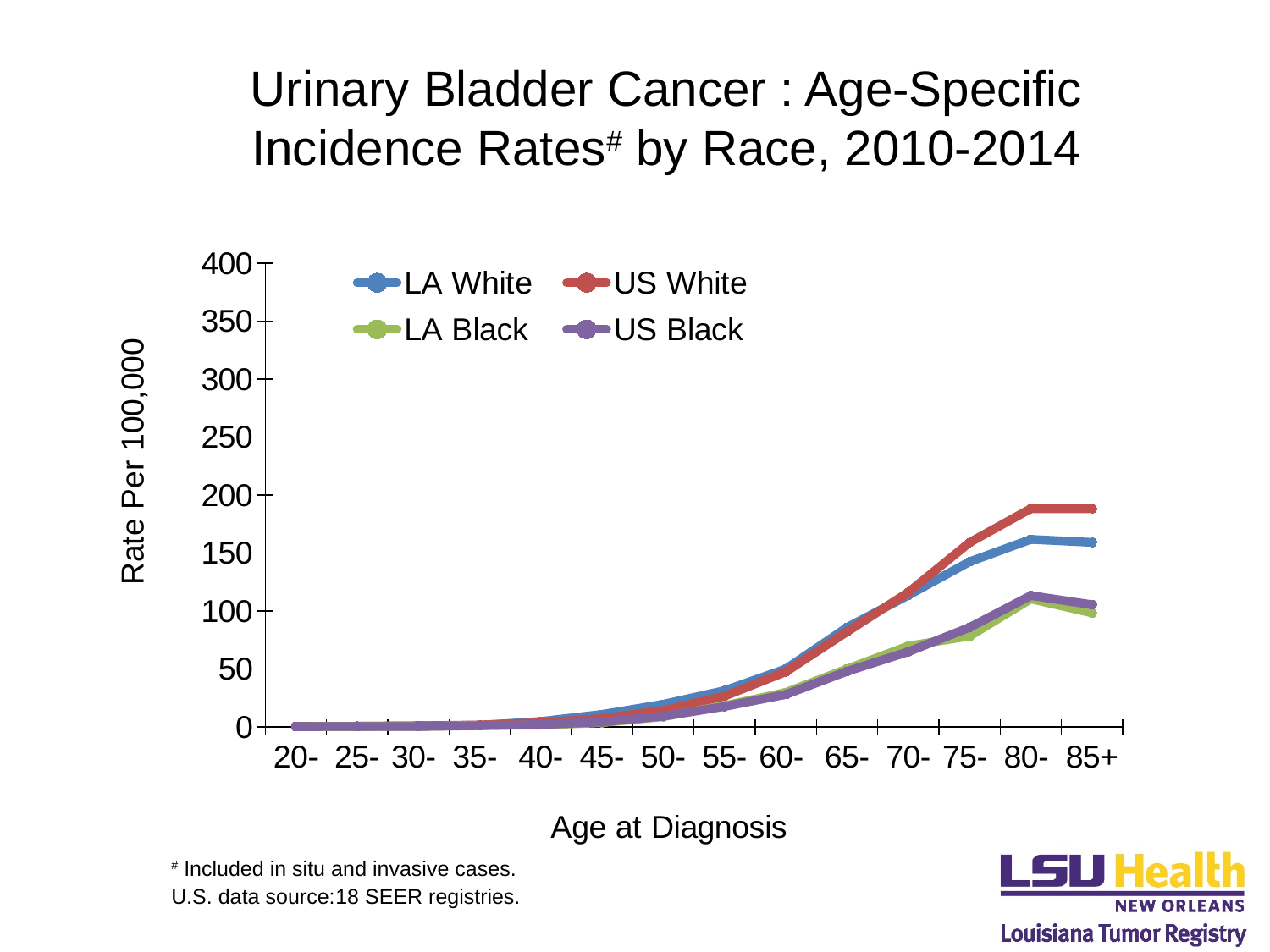
Which is larger at age 85+, the value for US White or the value for US Black? US White Do the incidence rates for LA White rise or fall from age 20- to age 80-? rise Which series has the highest value at age 80-? US White Is the value for LA White at age 60- greater or less than 100? less What kind of chart is shown on the slide? line chart How many age groups are shown on the x axis? 14 What is the label of the y axis? Rate Per 100,000 What is the label of the x axis? Age at Diagnosis Which series has the lowest value at age 85+? LA Black Is the value for US White at age 80- greater or less than 150? greater How many series does the legend list? 4 Is the value for LA Black at age 85+ greater or less than 150? less